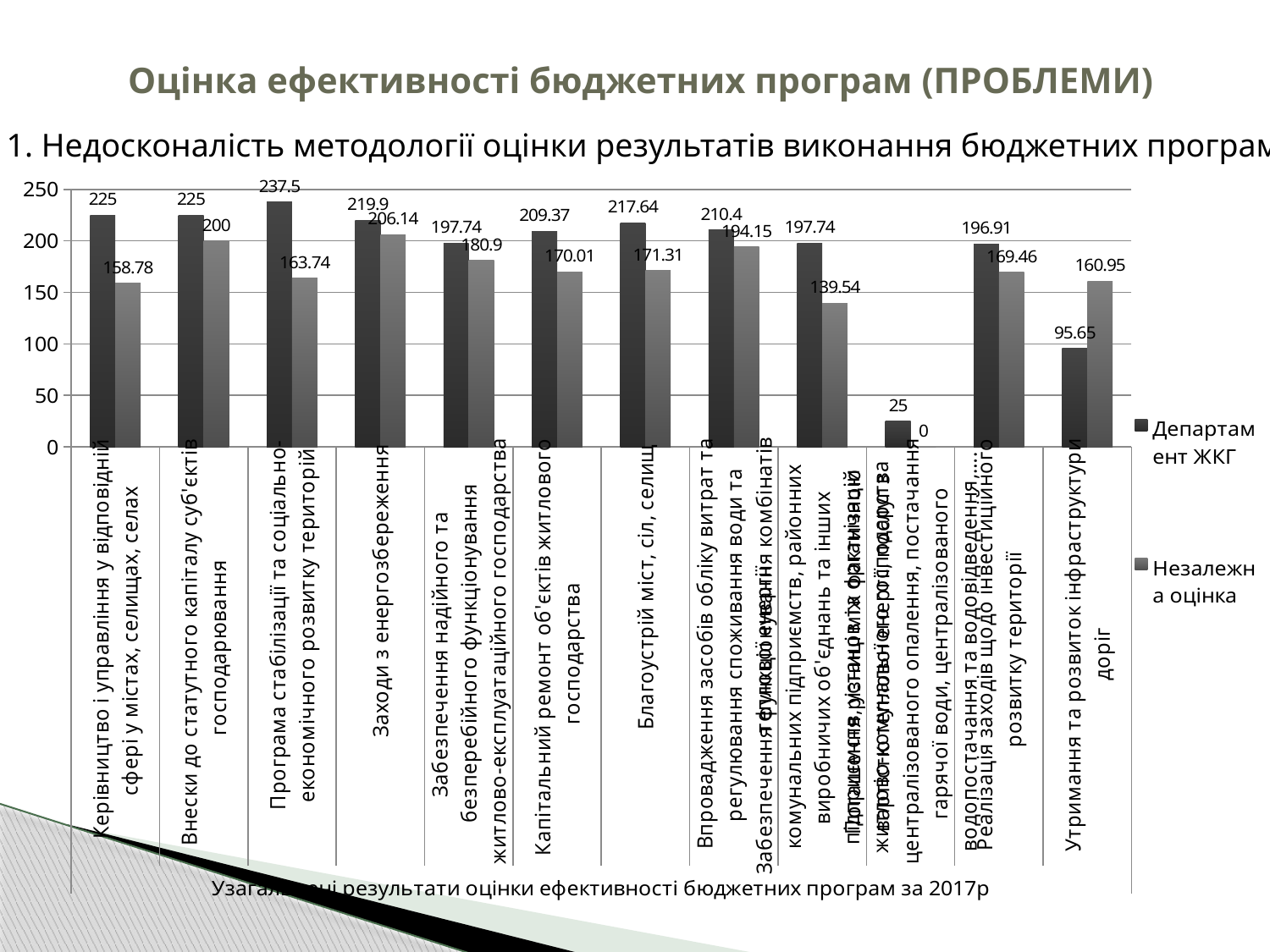
What is the difference between the Департамент ЖКГ value and the Незалежна оцінка value for Внески до статутного капіталу суб'єктів господарювання? 25 Is the Незалежна оцінка value for Капітальний ремонт об'єктів житлового господарства greater or less than 200? less Which category has the lowest value in the Незалежна оцінка series? Погашення різниці між фактичною вартістю теплової енергії, послуг з централізованого опалення, постачання гарячої води, централізованого водопостачання та водовідведення,…. For Утримання та розвиток інфраструктури доріг, which series has the larger value: Департамент ЖКГ or Незалежна оцінка? Незалежна оцінка What is the difference between the Департамент ЖКГ and Незалежна оцінка values for Керівництво і управління у відповідній сфері у містах, селищах, селах? 66.22 Which category has the highest value in the Департамент ЖКГ series? Програма стабілізації та соціально-економічного розвитку територій What type of chart is shown on the slide? bar chart What is the value of the Департамент ЖКГ series for Заходи з енергозбереження? 219.9 What is the axis title shown below the categories of the chart? Узагальнені результати оцінки ефективності бюджетних програм за 2017р What is the value of the Незалежна оцінка series for Благоустрій міст, сіл, селищ? 171.31 How many series does the legend list? 2 What is the value of the Незалежна оцінка series for Утримання та розвиток інфраструктури доріг? 160.95